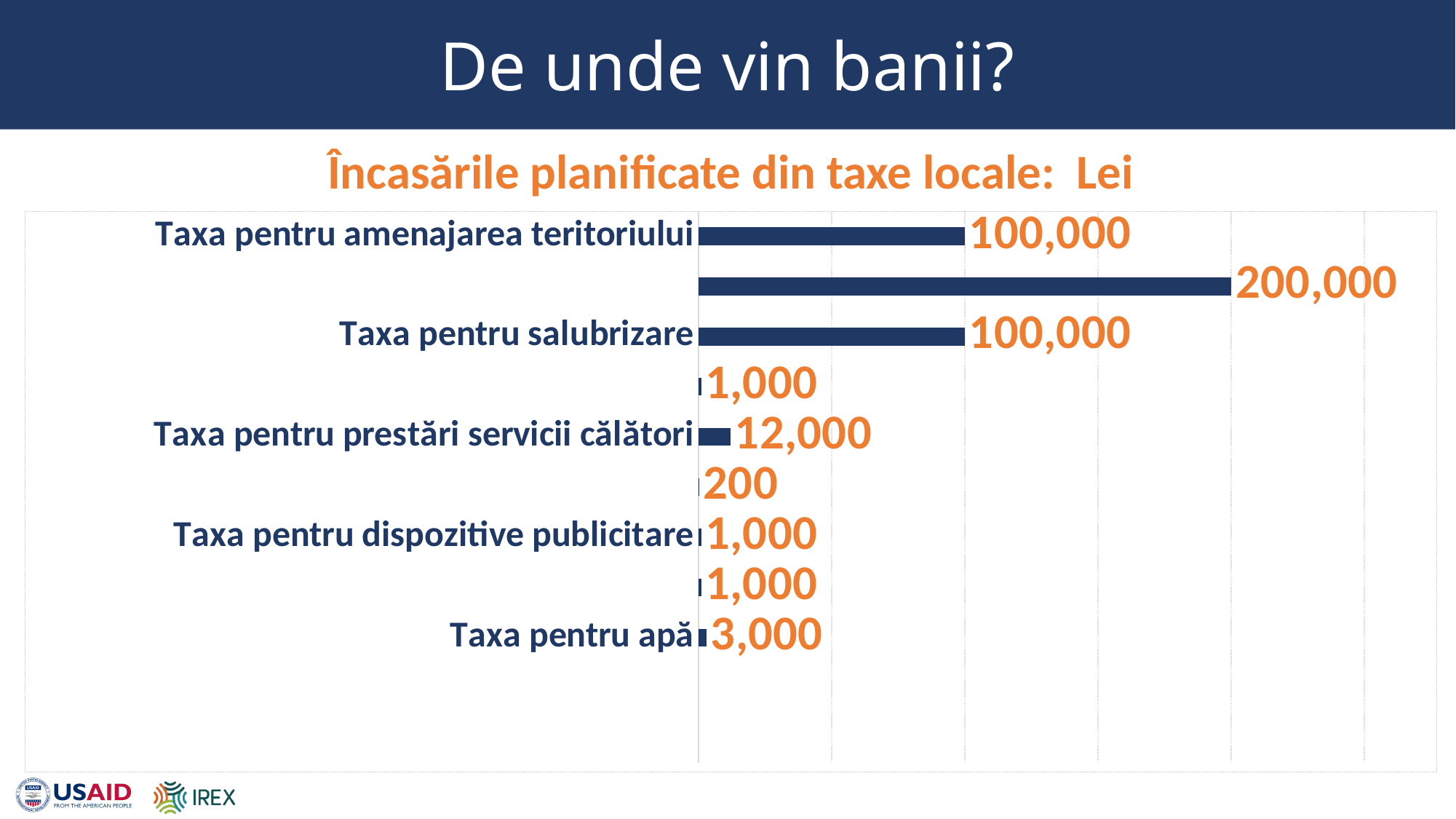
What is the planned value for Taxa pentru amenajarea teritoriului? 100,000 What is the planned value for Taxa pentru apă? 3,000 Which is larger, the value for Taxa pentru apă or the value for Taxa pentru dispozitive publicitare? Taxa pentru apă What is the planned value for Taxa pentru prestări servicii călători? 12,000 What kind of chart is shown on the slide? Bar chart What is the planned value for Taxa pentru salubrizare? 100,000 What is the title of the chart? Încasările planificate din taxe locale: Lei What is the planned value for Taxa pentru dispozitive publicitare? 1,000 How many bars are plotted in the chart? 9 What is the largest value labelled on any bar in the chart? 200,000 What is the difference between the values for Taxa pentru prestări servicii călători and Taxa pentru apă? 9,000 What is the difference between the values for Taxa pentru amenajarea teritoriului and Taxa pentru prestări servicii călători? 88,000